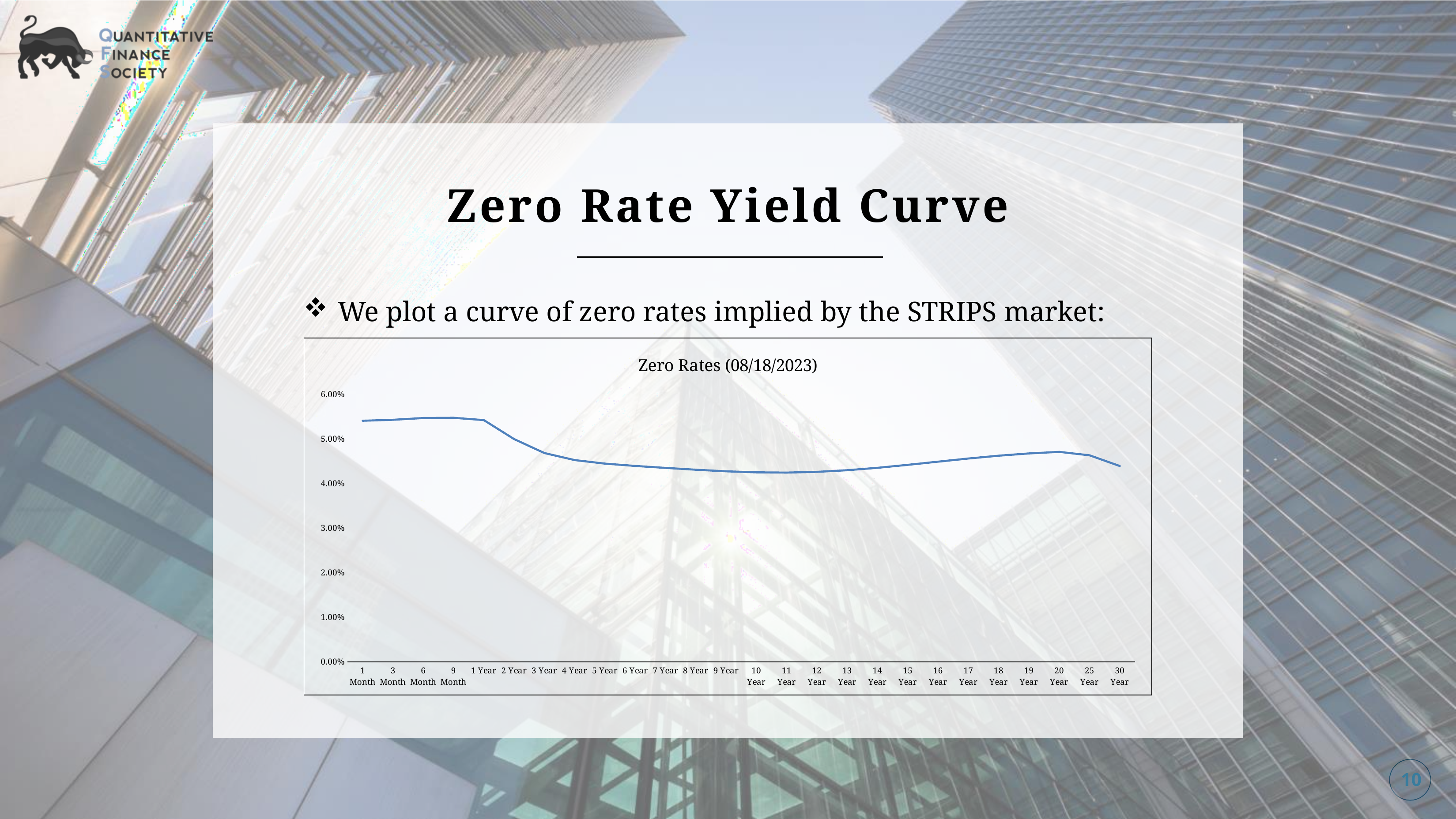
Which has the higher zero rate, 20 Year or 10 Year? 20 Year Which has the higher zero rate, 1 Month or 10 Year? 1 Month Is the zero rate for 30 Year greater or less than 5.00%? less What is the highest value shown on the y axis of the chart? 6.00% Is the zero rate for 10 Year greater or less than 5.00%? less Does the zero rate rise or fall between 10 Year and 20 Year? rise What kind of chart is shown on the slide? line chart How many maturity points are plotted along the x axis of the chart? 26 Is the zero rate for 20 Year greater or less than 4.00%? greater What is the title of the chart? Zero Rates (08/18/2023) Does the zero rate rise or fall between 1 Year and 10 Year? fall